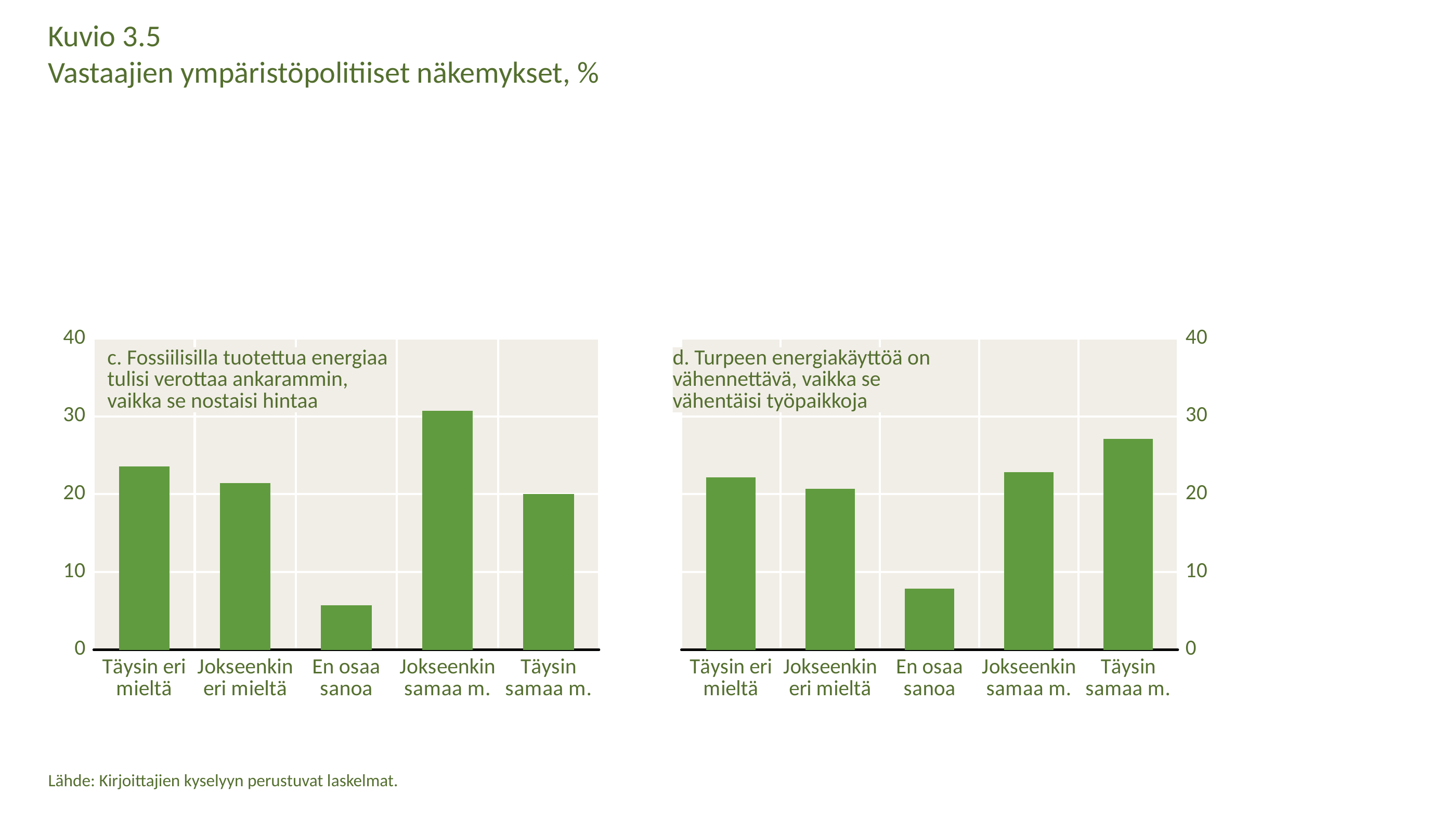
What kind of chart is the right chart (d. Turpeen energiakäyttöä on vähennettävä)? Bar chart In the left chart (c. Fossiilisilla tuotettua energiaa tulisi verottaa ankarammin), which category has the highest bar? Jokseenkin samaa m. In the left chart (c. Fossiilisilla tuotettua energiaa tulisi verottaa ankarammin), which category has the lowest bar? En osaa sanoa In the left chart (c. Fossiilisilla tuotettua energiaa tulisi verottaa ankarammin), which is larger: Täysin eri mieltä or Täysin samaa m.? Täysin eri mieltä In the right chart (d. Turpeen energiakäyttöä on vähennettävä), is the value for En osaa sanoa greater or less than 10? less In the right chart (d. Turpeen energiakäyttöä on vähennettävä), which category has the highest bar? Täysin samaa m. In the right chart (d. Turpeen energiakäyttöä on vähennettävä), is the value for Täysin samaa m. greater or less than 30? less In the left chart (c. Fossiilisilla tuotettua energiaa tulisi verottaa ankarammin), is the value for En osaa sanoa greater or less than 10? less In the right chart (d. Turpeen energiakäyttöä on vähennettävä), which category has the lowest bar? En osaa sanoa How many categories are shown on the x axis of the left chart (c. Fossiilisilla tuotettua energiaa tulisi verottaa ankarammin)? 5 In the right chart (d. Turpeen energiakäyttöä on vähennettävä), which is larger: Täysin samaa m. or Jokseenkin eri mieltä? Täysin samaa m.